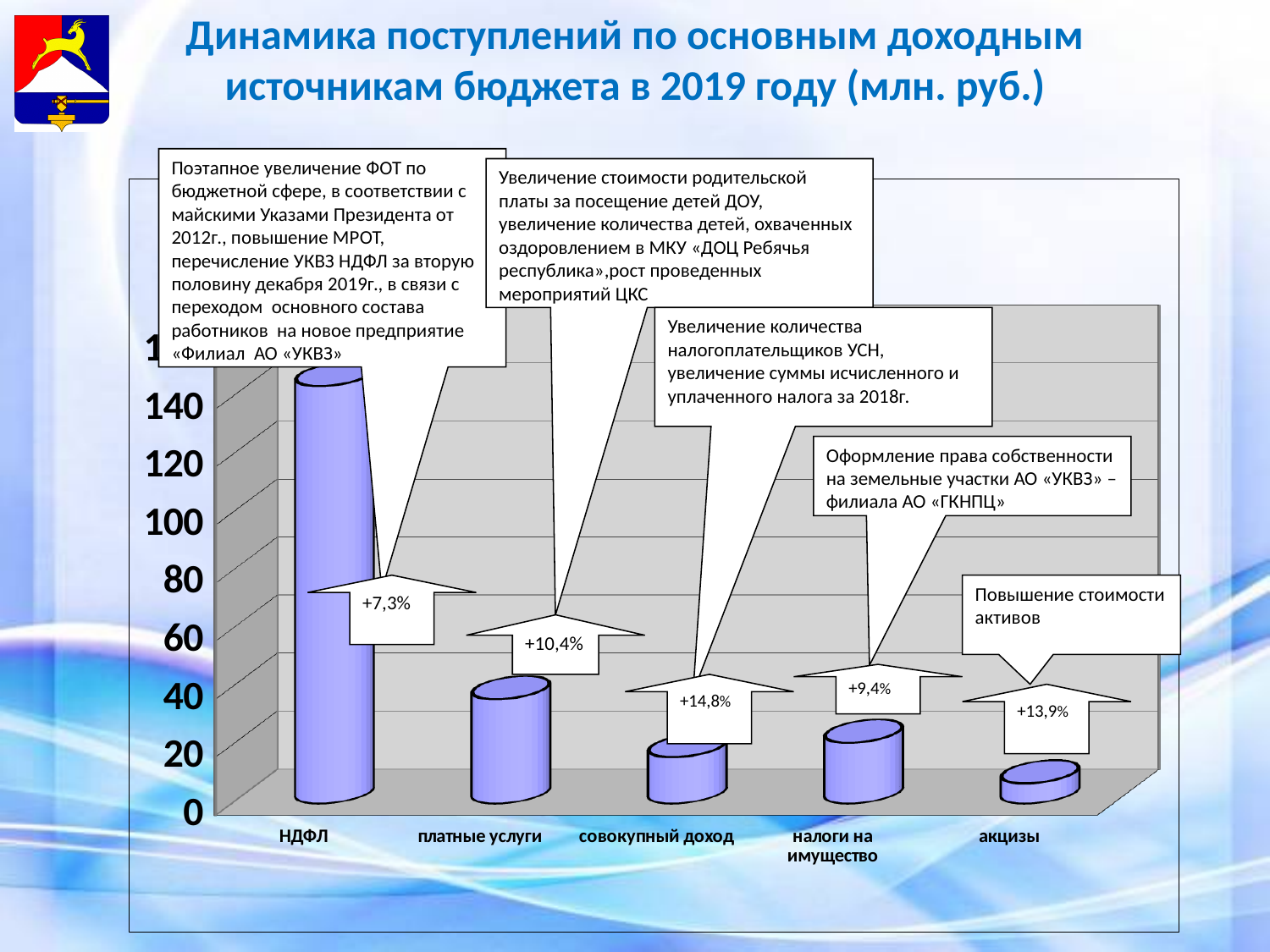
Which is larger, the value for платные услуги or the value for налоги на имущество? платные услуги Is the value for акцизы greater or less than 20? less Which category has the highest bar in the chart? НДФЛ What percentage growth is shown in the arrow above the совокупный доход bar? +14,8% What is the title of the slide containing the chart? Динамика поступлений по основным доходным источникам бюджета в 2019 году (млн. руб.) Is the value for совокупный доход greater or less than 40? less What kind of chart is shown on the slide? bar chart Is the value for платные услуги greater or less than 60? less What percentage growth is shown in the arrow above the НДФЛ bar? +7,3% Which category has the lowest bar in the chart? акцизы How many categories are shown on the x axis of the chart? 5